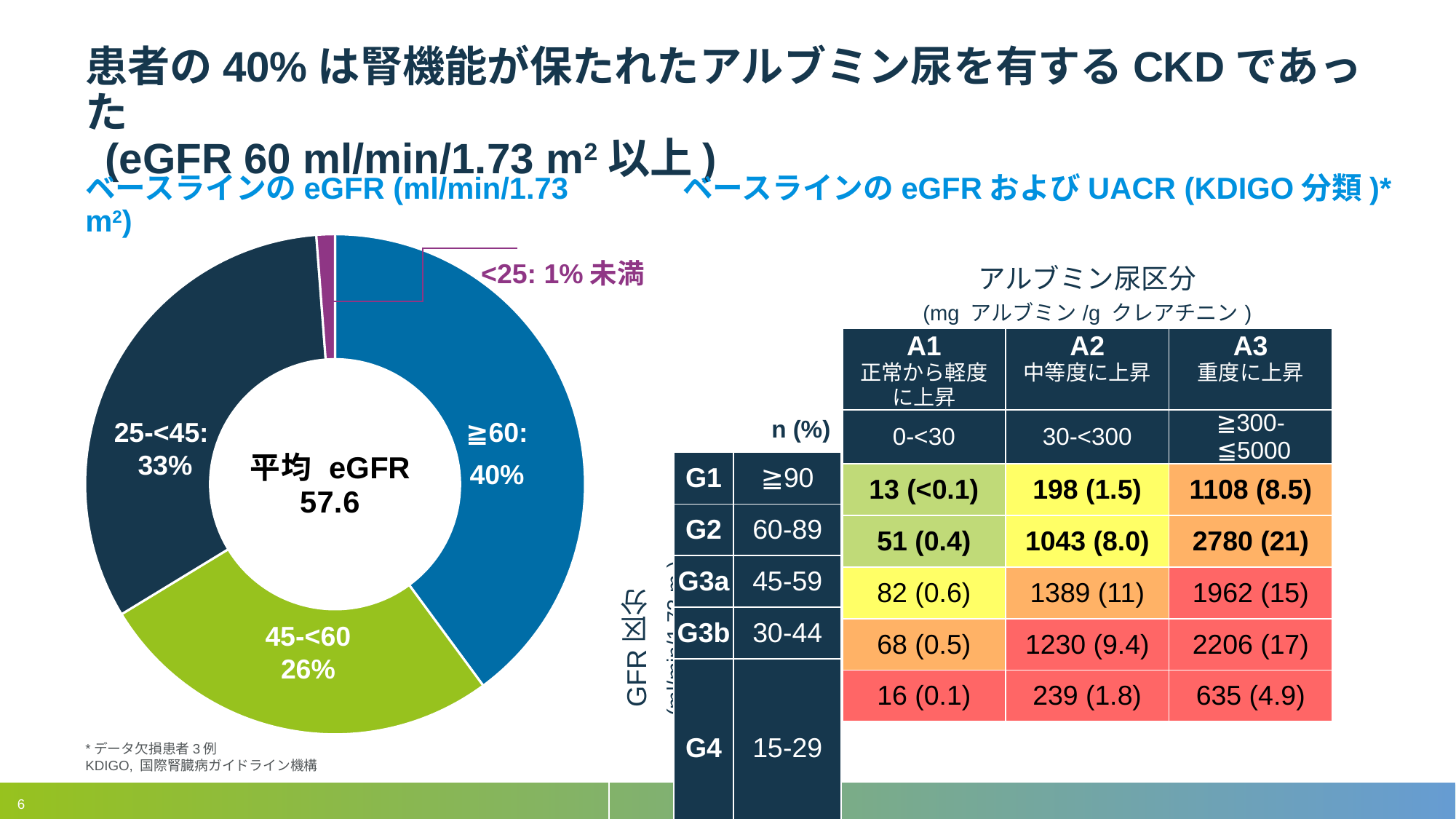
In the baseline eGFR donut chart, what percentage of patients had an eGFR of 25-<45? 33% In the baseline eGFR donut chart, what is the label shown for the <25 category? 1% 未満 In the donut chart, what is the difference in percentage points between the 25-<45 category and the 45-<60 category? 7 In the donut chart, which is larger: the share for 25-<45 or the share for 45-<60? 25-<45 What mean eGFR value is printed in the centre of the donut chart? 57.6 What kind of chart is shown on the left of the slide? Pie (donut) chart How many eGFR categories are shown in the donut chart? 4 Which eGFR category has the smallest share in the donut chart? <25 In the donut chart, what is the difference in percentage points between the ≧60 category and the 45-<60 category? 14 In the baseline eGFR donut chart, what percentage of patients had an eGFR of 45-<60? 26% Which eGFR category has the largest share in the donut chart? ≧60 In the baseline eGFR donut chart, what percentage of patients had an eGFR of ≧60? 40%